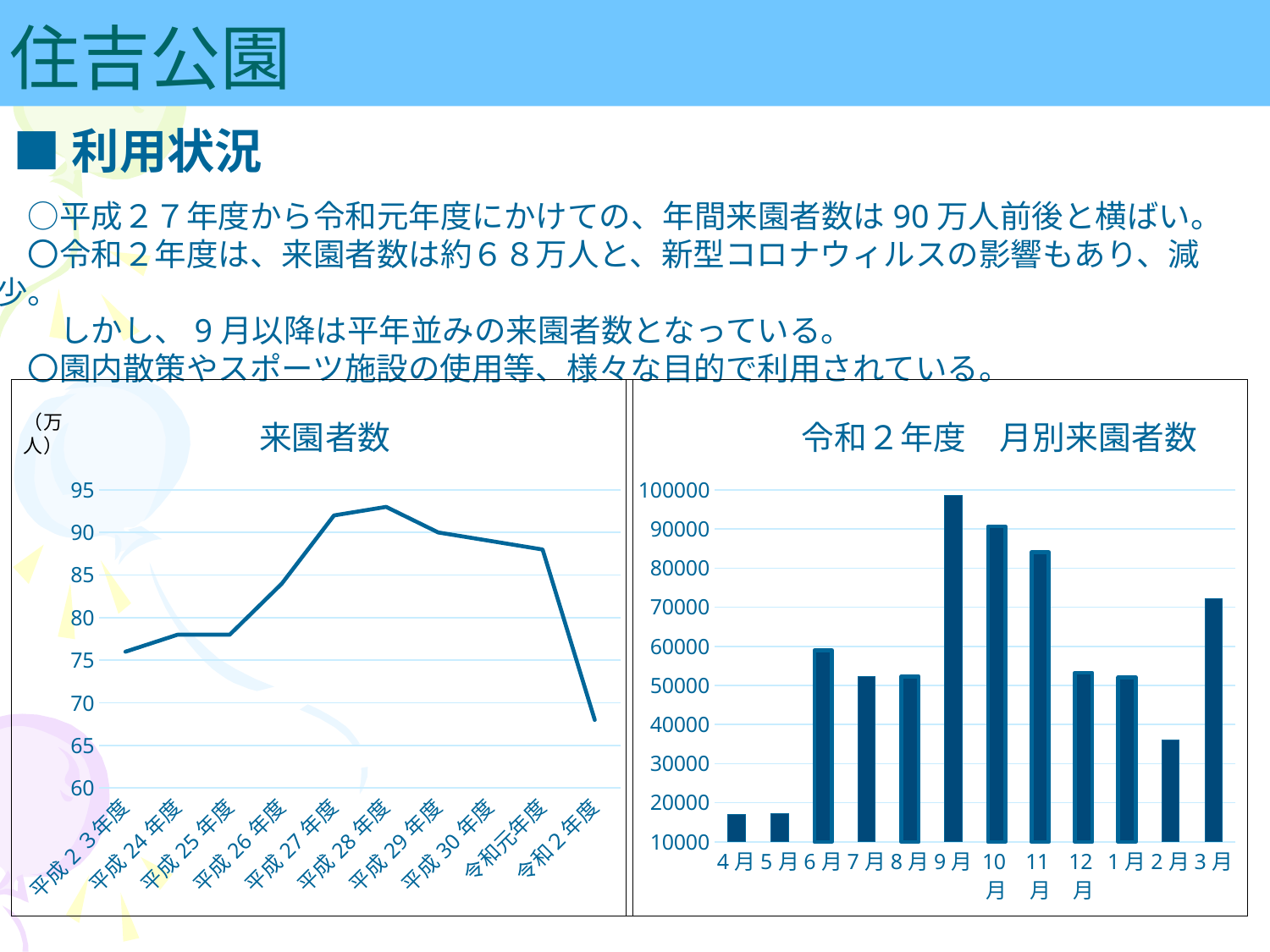
In the right chart 令和２年度 月別来園者数, how many months are shown as bars? 12 What unit label is shown at the top of the y axis of the left chart 来園者数? (万人) In the left chart 来園者数, is the value for 平成27年度 greater or less than 90? greater In the right chart 令和２年度 月別来園者数, which month has the highest value? 9月 In the left chart 来園者数, how many fiscal years are plotted on the x axis? 10 In the left chart 来園者数, which fiscal year has the lowest value? 令和２年度 In the right chart 令和２年度 月別来園者数, is the value for 2月 greater or less than 40000? less In the right chart 令和２年度 月別来園者数, which is larger, the value for 6月 or the value for 7月? 6月 In the left chart 来園者数, do the values rise or fall from 平成23年度 to 平成28年度? rise What kind of chart is the left chart titled 来園者数? line chart In the left chart 来園者数, is the value for 令和２年度 greater or less than 70? less What kind of chart is the right chart titled 令和２年度 月別来園者数? bar chart